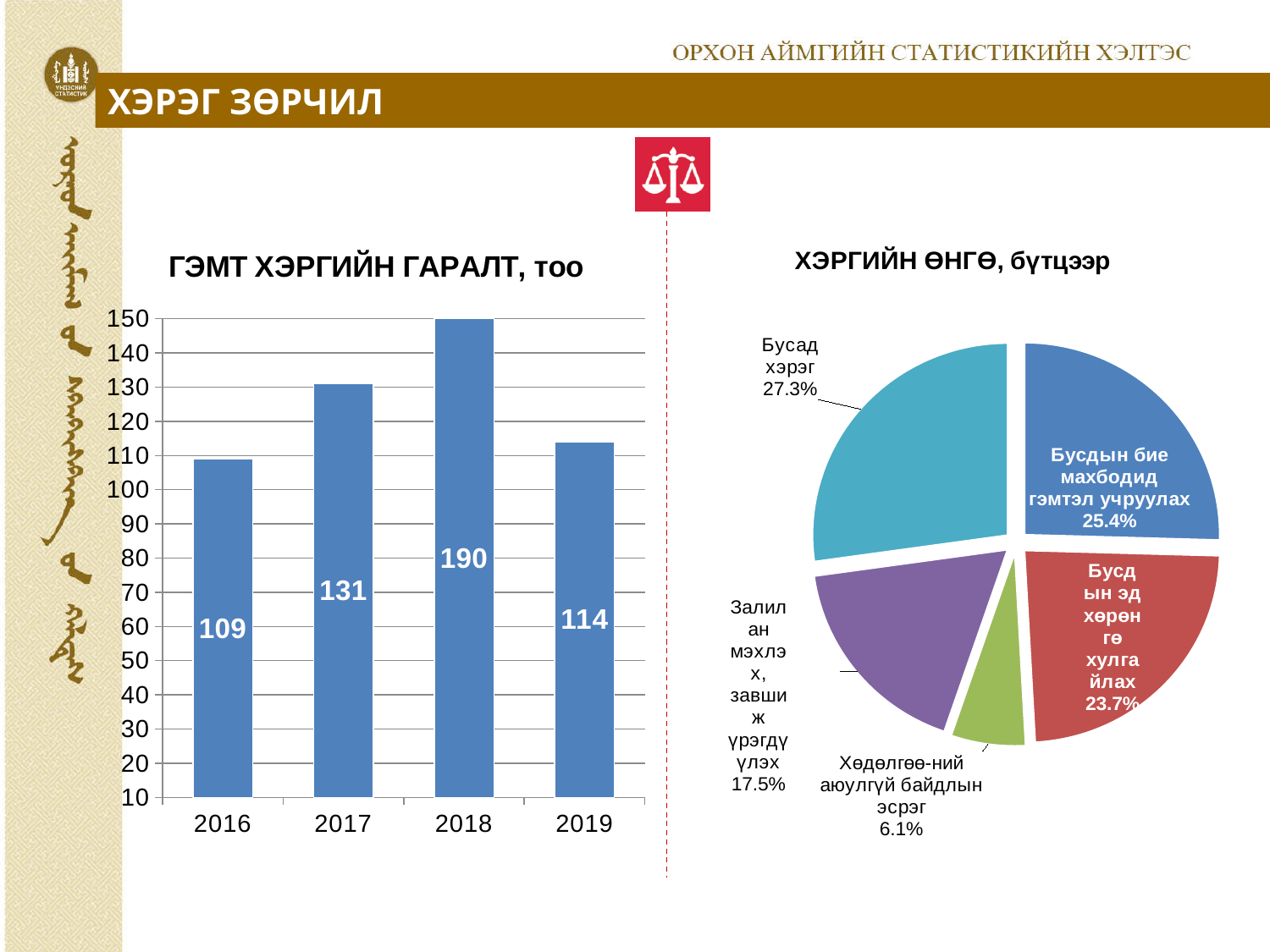
In the bar chart "ГЭМТ ХЭРГИЙН ГАРАЛТ, тоо", which is larger, the value for 2017 or the value for 2019? 2017 In the bar chart "ГЭМТ ХЭРГИЙН ГАРАЛТ, тоо", what is the value for 2016? 109 In the bar chart "ГЭМТ ХЭРГИЙН ГАРАЛТ, тоо", how many years are shown on the x axis? 4 In the bar chart "ГЭМТ ХЭРГИЙН ГАРАЛТ, тоо", which year has the highest value? 2018 What kind of chart is "ГЭМТ ХЭРГИЙН ГАРАЛТ, тоо"? bar chart In the bar chart "ГЭМТ ХЭРГИЙН ГАРАЛТ, тоо", what is the value for 2019? 114 In the pie chart "ХЭРГИЙН ӨНГӨ, бүтцээр", how many slices are there? 5 In the pie chart "ХЭРГИЙН ӨНГӨ, бүтцээр", what share does "Хөдөлгөөний аюулгүй байдлын эсрэг" have? 6.1% In the bar chart "ГЭМТ ХЭРГИЙН ГАРАЛТ, тоо", what is the difference between the values for 2017 and 2016? 22 In the pie chart "ХЭРГИЙН ӨНГӨ, бүтцээр", what share does "Бусад хэрэг" have? 27.3% In the pie chart "ХЭРГИЙН ӨНГӨ, бүтцээр", which category has the smallest slice? Хөдөлгөөний аюулгүй байдлын эсрэг In the bar chart "ГЭМТ ХЭРГИЙН ГАРАЛТ, тоо", which year has the lowest value? 2016